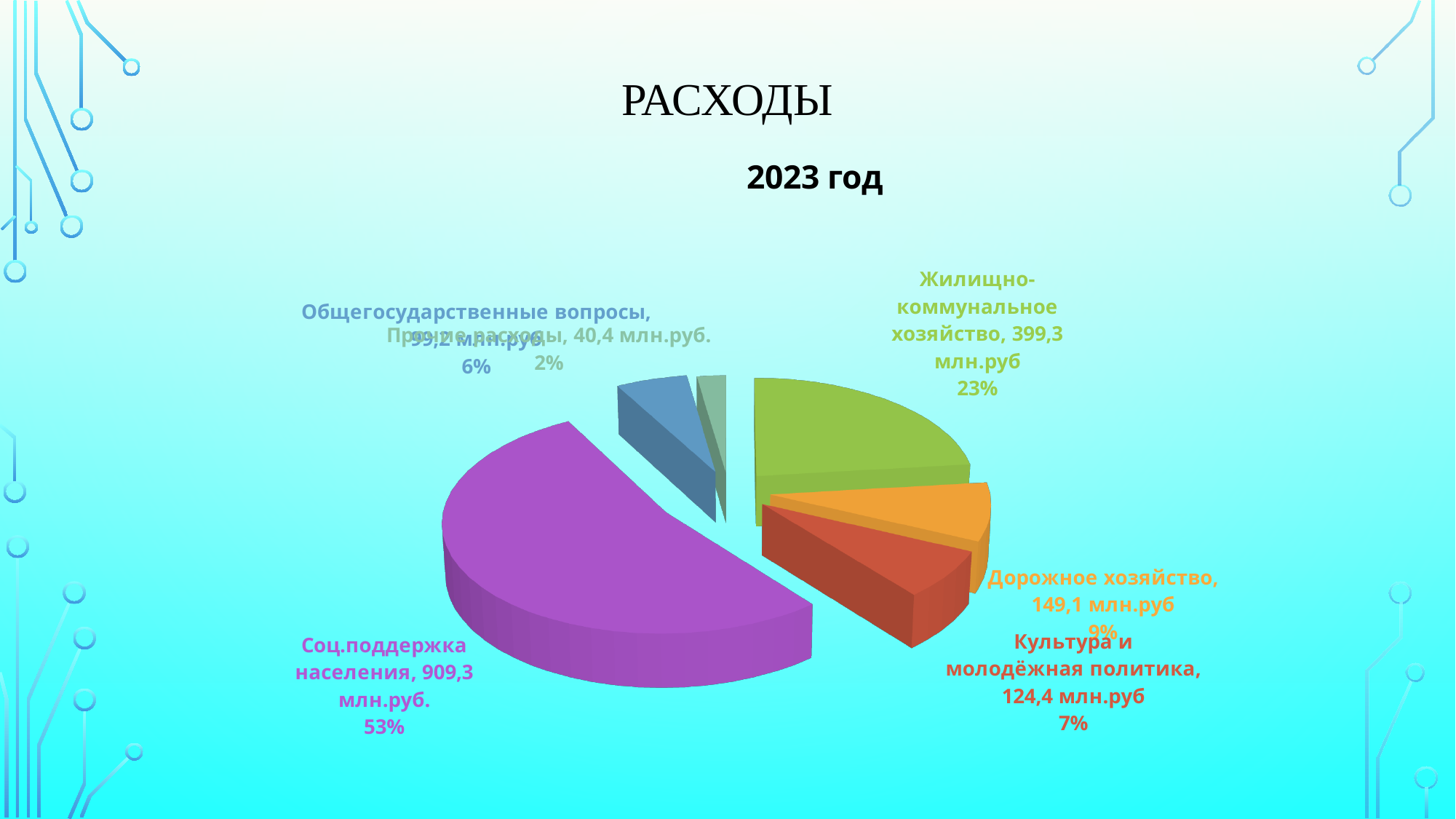
What is the difference between the values for Жилищно-коммунальное хозяйство and Дорожное хозяйство? 250,2 млн.руб Which is larger, Дорожное хозяйство or Культура и молодёжная политика? Дорожное хозяйство What kind of chart is shown on the slide? Pie chart What colour is the slice for Соц.поддержка населения? Purple What share of the pie does Жилищно-коммунальное хозяйство represent? 23% Which category has the smallest slice? Прочие расходы What is the chart's title? 2023 год What is the value for Дорожное хозяйство? 149,1 млн.руб How many slices does the pie chart have? 6 What percentage is shown for Культура и молодёжная политика? 7% What is the value for Соц.поддержка населения? 909,3 млн.руб. Which category has the largest slice? Соц.поддержка населения